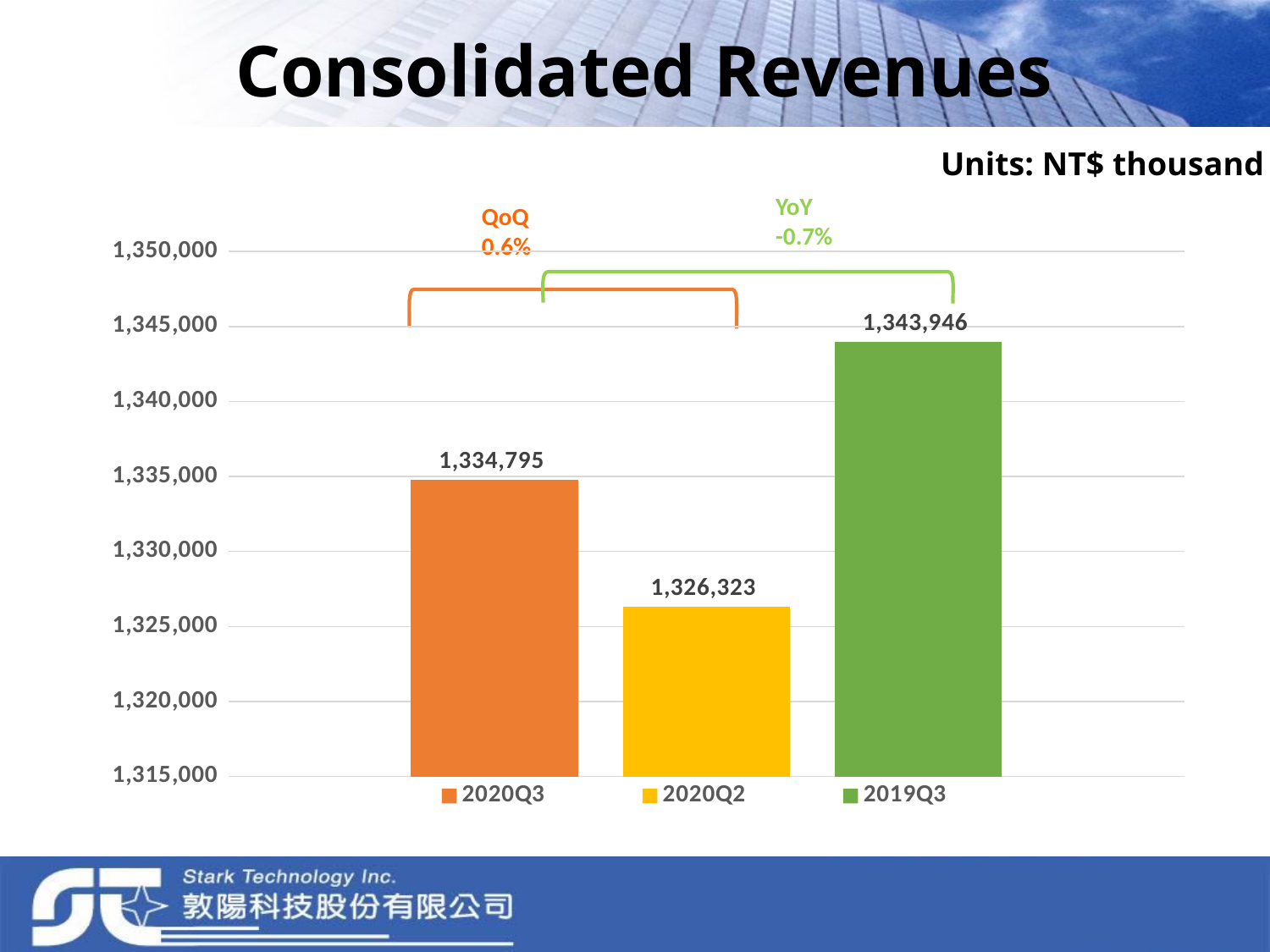
What is the consolidated revenue for 2020Q2? 1,326,323 What YoY percentage change is shown on the chart? -0.7% What is the consolidated revenue for 2020Q3? 1,334,795 What is the difference between the 2020Q3 and 2020Q2 revenues? 8,472 What is the consolidated revenue for 2019Q3? 1,343,946 Which quarter has the lowest consolidated revenue? 2020Q2 Which quarter has the highest consolidated revenue? 2019Q3 What kind of chart is shown on the slide? bar chart What is the difference between the 2019Q3 and 2020Q3 revenues? 9,151 How many bars are shown in the chart? 3 Which is larger, the revenue for 2020Q3 or for 2020Q2? 2020Q3 Is the value for 2020Q2 greater or less than 1,330,000? less